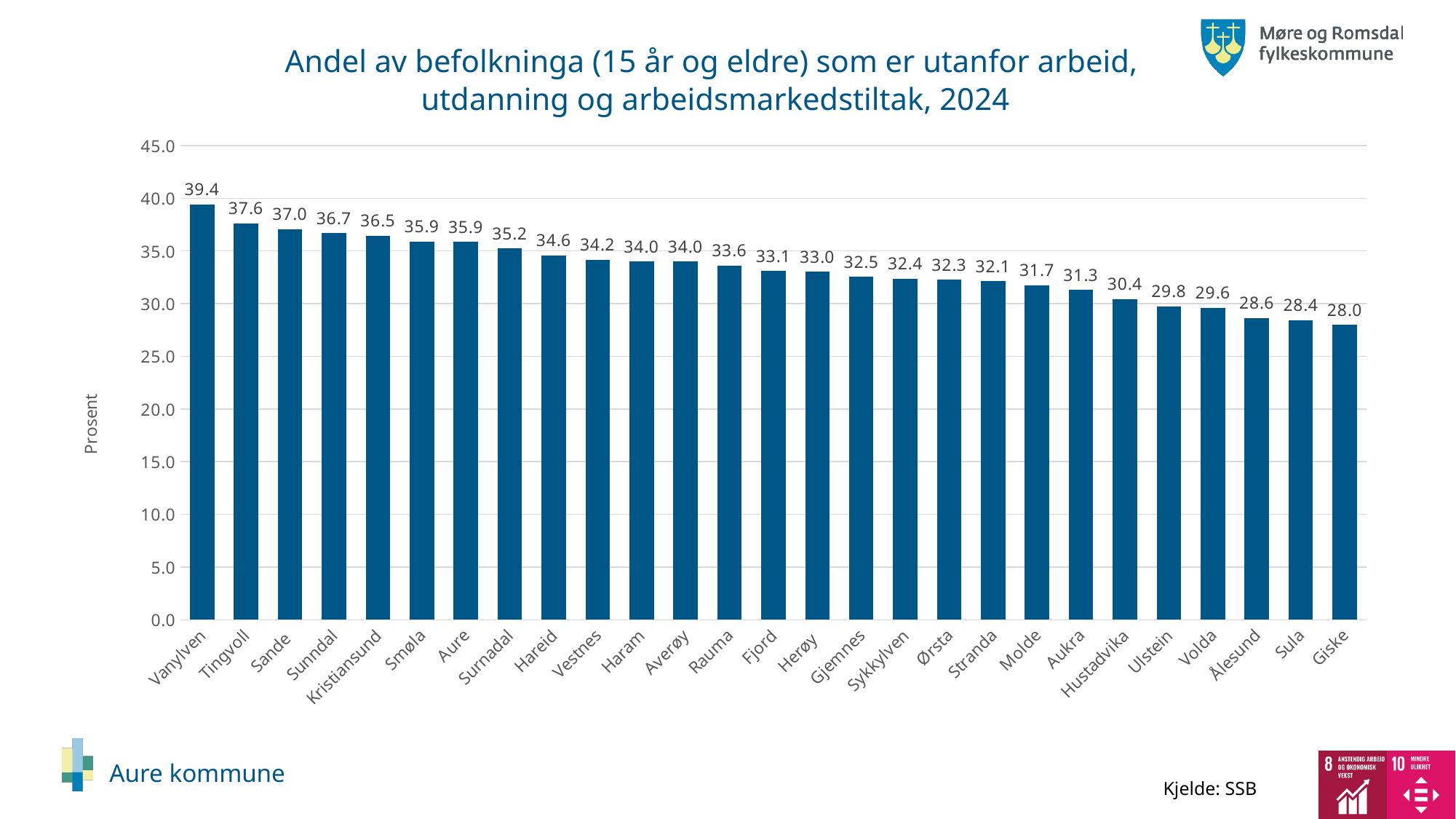
What is the value for Molde? 31.7 What is the value for Aure? 35.9 What is the label of the vertical axis? Prosent Is the value for Ulstein greater or less than 30.0? less Which municipality has the highest value? Vanylven What kind of chart is shown on the slide? bar chart What is the difference between the values for Tingvoll and Ålesund? 9.0 How many municipalities are shown on the chart? 27 What is the value for Kristiansund? 36.5 What is the difference between the values for Vanylven and Giske? 11.4 Which municipality has the lowest value? Giske Which is larger, the value for Sunndal or the value for Hustadvika? Sunndal